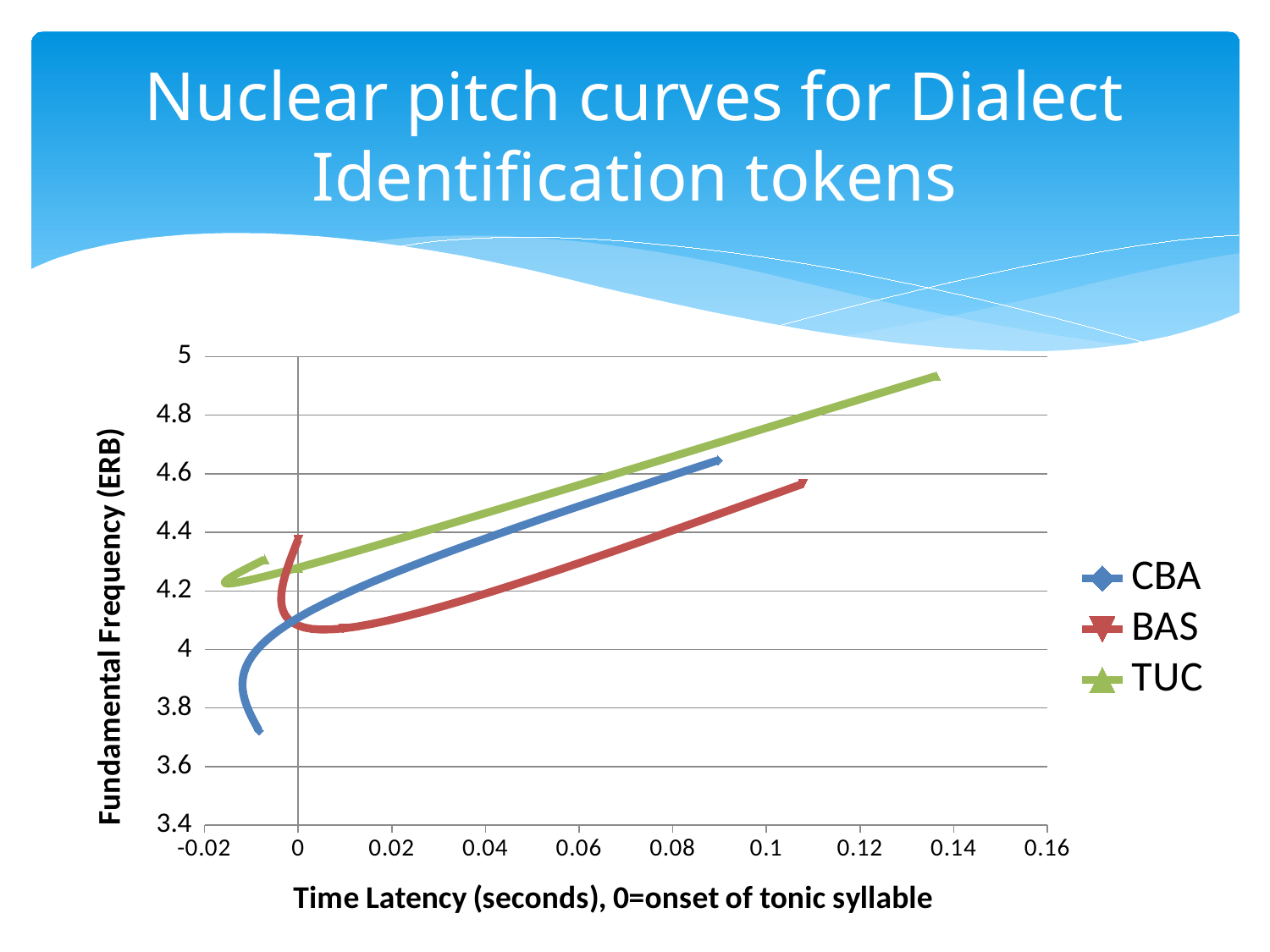
Which series ends at a higher fundamental frequency, CBA or BAS? CBA What are the three series named in the legend? CBA, BAS, TUC Which series reaches the highest fundamental frequency on the chart? TUC Do the pitch curves generally rise or fall as time latency increases past the onset of the tonic syllable? rise Is the lowest value of the CBA curve greater or less than 3.8 ERB? less What kind of chart is shown on the slide? line chart Is the highest value reached by the TUC curve greater or less than 4.8 ERB? greater Which series extends furthest to the right along the time latency axis, TUC or BAS? TUC Which series reaches the lowest fundamental frequency on the chart? CBA Is the final (rightmost) value of the BAS curve greater or less than 4.4 ERB? greater What is the title of the chart's x axis? Time Latency (seconds), 0=onset of tonic syllable How many series does the legend list? 3